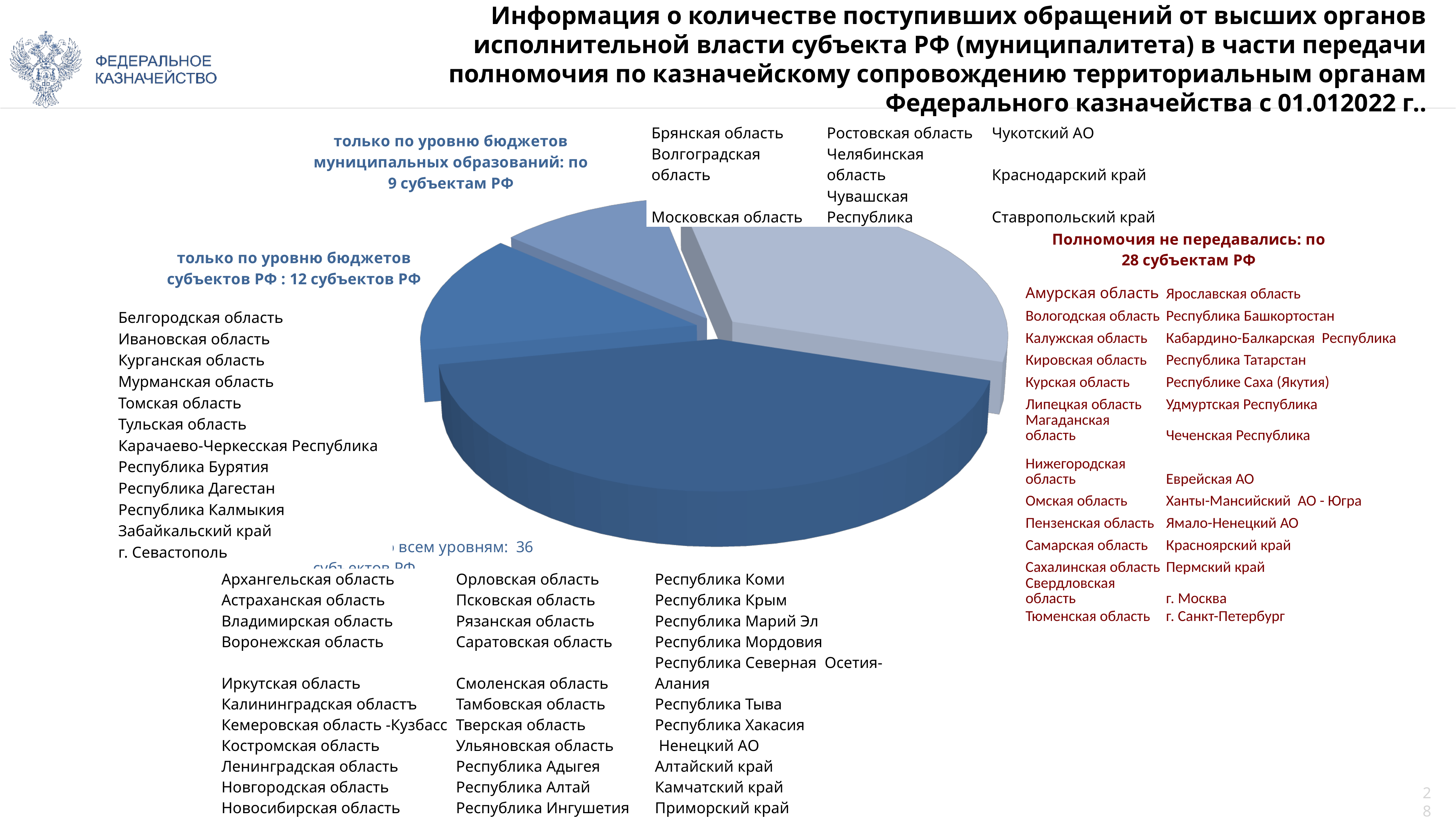
Which category has the largest slice of the pie chart? по всем уровням What kind of chart is shown on the slide? pie chart How many slices does the pie chart have? 4 What is the total number of subjects of the RF across all four slices of the pie chart? 85 How many subjects of the RF transferred powers at all levels (по всем уровням)? 36 How many subjects of the RF transferred powers only at the level of subject budgets (только по уровню бюджетов субъектов РФ)? 12 What is the difference between the number of subjects that transferred powers at all levels and the number that did not transfer powers? 8 In what colour is the label for the category 'Полномочия не передавались' written? dark red Which category has the smallest slice of the pie chart? только по уровню бюджетов муниципальных образований Which is larger: the number of subjects that transferred powers only at the subject budget level or only at the municipal budget level? only at the subject budget level (12) How many subjects of the RF transferred powers only at the level of municipal budgets (только по уровню бюджетов муниципальных образований)? 9 How many subjects of the RF did not transfer powers (Полномочия не передавались)? 28